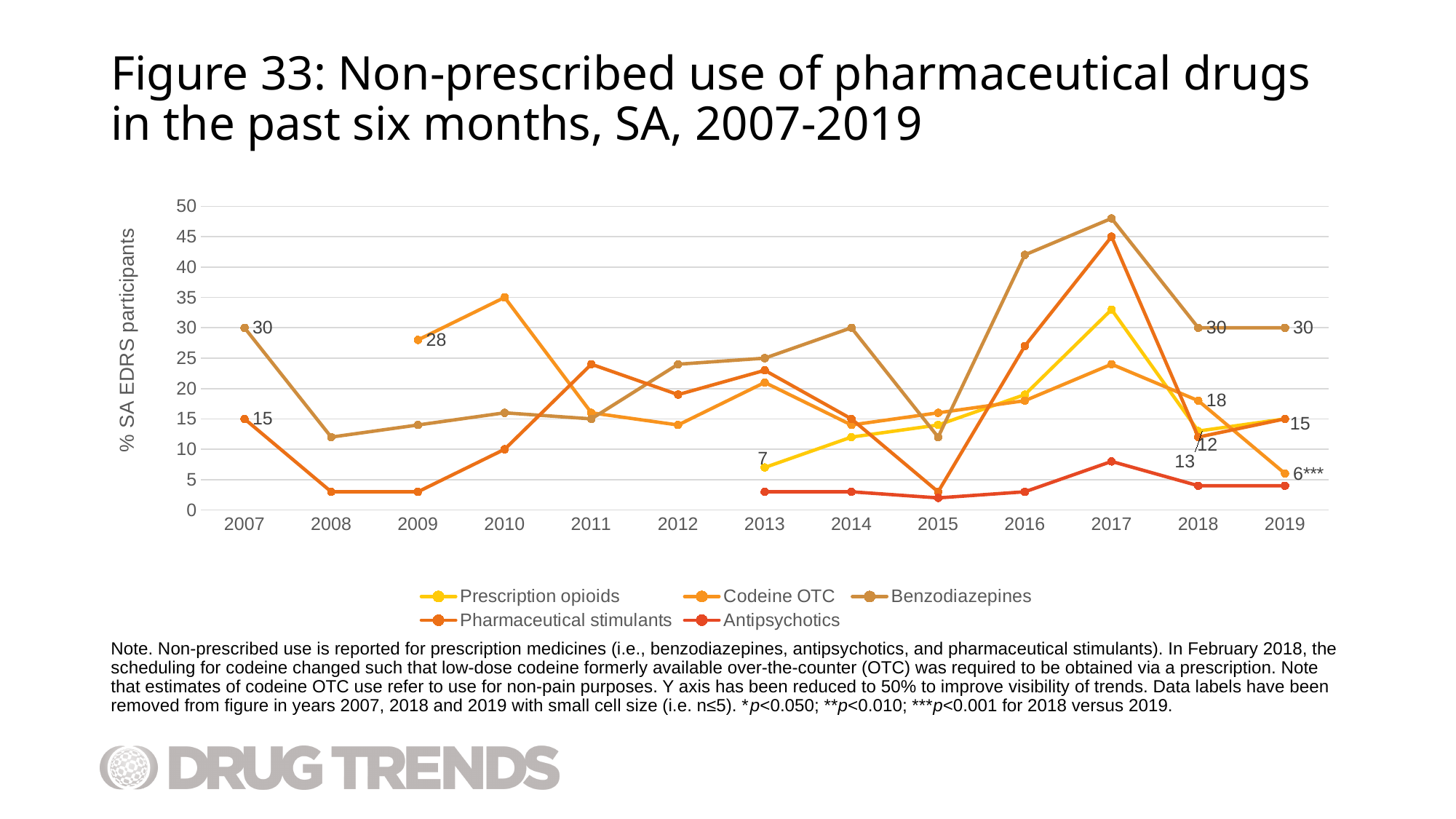
Is the value for Benzodiazepines in 2017 greater or less than 45? greater What is the value for Benzodiazepines in 2007? 30 How many years are shown on the x axis? 13 What is the value for Codeine OTC in 2018? 18 What is the label on the y axis? % SA EDRS participants What is the value for Codeine OTC in 2009? 28 In which year does the Benzodiazepines line reach its highest value? 2017 How many series does the legend list? 5 What is the value for Benzodiazepines in 2019? 30 What is the value for Prescription opioids in 2013? 7 What type of chart is shown on the slide? Line chart What is the difference between Benzodiazepines and Pharmaceutical stimulants in 2007? 15